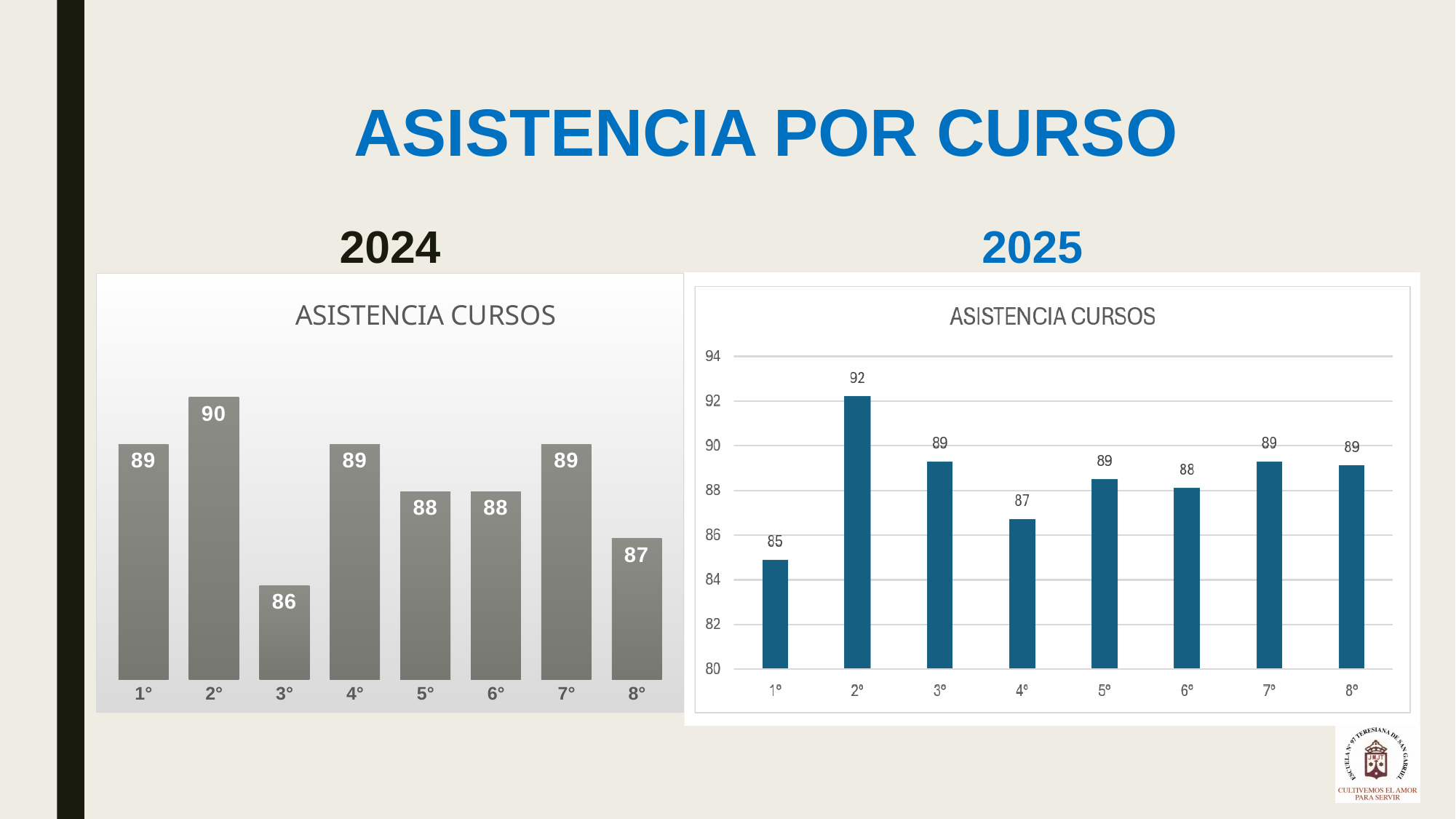
In the 2025 chart, what is the value for 1°? 85 In the 2025 chart, which course has the lowest value? 1° In the 2024 chart, which course has the highest value? 2° In the 2025 chart, is the value for 2° greater or less than 90? greater What is the title of the 2025 chart? ASISTENCIA CURSOS In the 2024 chart, what is the difference between the values for 2° and 3°? 4 In the 2024 chart, what is the value for 3°? 86 What kind of chart is the 2025 chart? bar chart In the 2025 chart, which is larger, the value for 4° or the value for 6°? 6° In the 2025 chart, which course has the highest value? 2° How many courses are shown in the 2024 chart? 8 In the 2025 chart, what is the difference between the values for 2° and 1°? 7